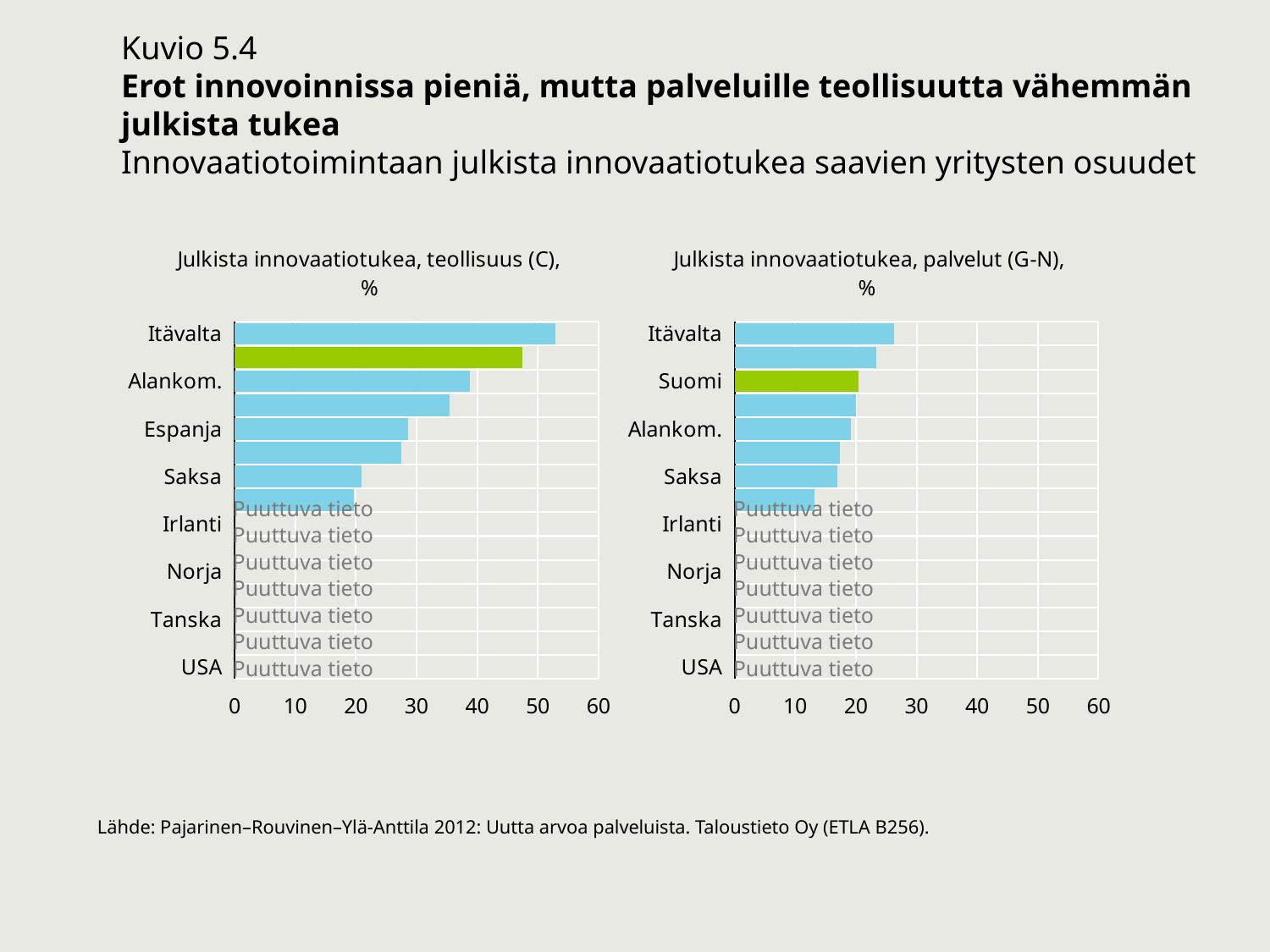
In the left chart (teollisuus), is the value for Itävalta greater or less than 50? greater In the left chart (teollisuus), which is larger, the value for Itävalta or the value for Saksa? Itävalta What is the highest tick value shown on the x axis of the left chart (teollisuus)? 60 In the right chart (palvelut), is the value for Itävalta greater or less than 20? greater What kind of chart is the left chart, 'Julkista innovaatiotukea, teollisuus (C), %'? bar chart In the left chart (teollisuus), which labelled country has the highest value? Itävalta In the right chart (palvelut), is the value for Saksa greater or less than 20? less In the right chart (palvelut), which labelled country has the highest value? Itävalta In the right chart (palvelut), which is larger, the value for Itävalta or the value for Suomi? Itävalta In the right chart (palvelut), which country's bar is coloured green? Suomi